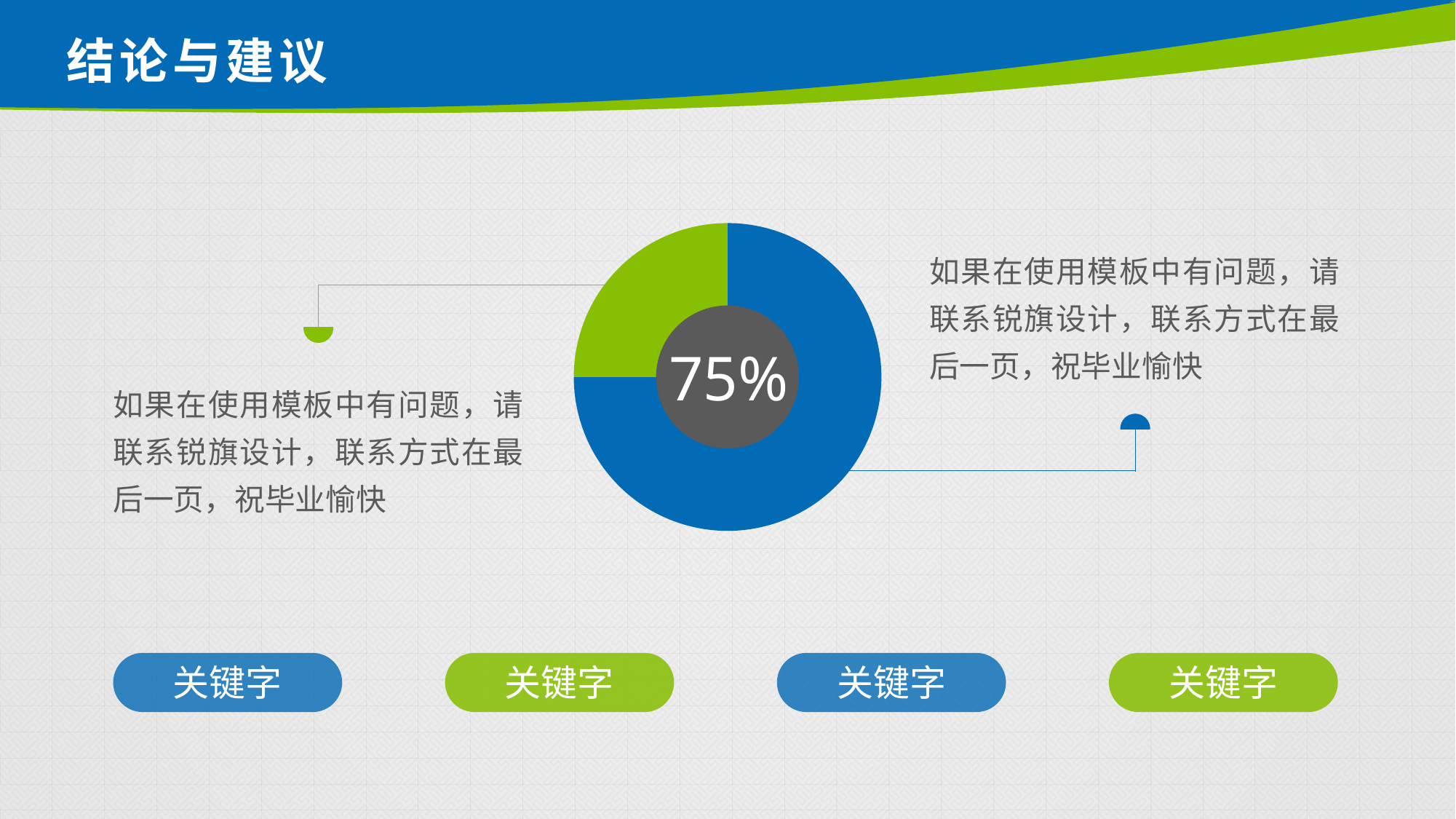
How many slices does the donut chart have? 2 What kind of chart is shown in the centre of the slide? Donut chart What percentage is printed in the centre of the donut chart? 75% Which colour slice is the smallest in the donut chart? Green Is the blue slice of the donut chart greater or less than 50% of the whole? greater What is the title of the slide containing the donut chart? 结论与建议 What share of the donut chart does the blue slice represent? 75% What two colours are used for the slices of the donut chart? Blue and green Which slice of the donut chart is larger, the blue one or the green one? Blue Is the green slice of the donut chart greater or less than 50% of the whole? less